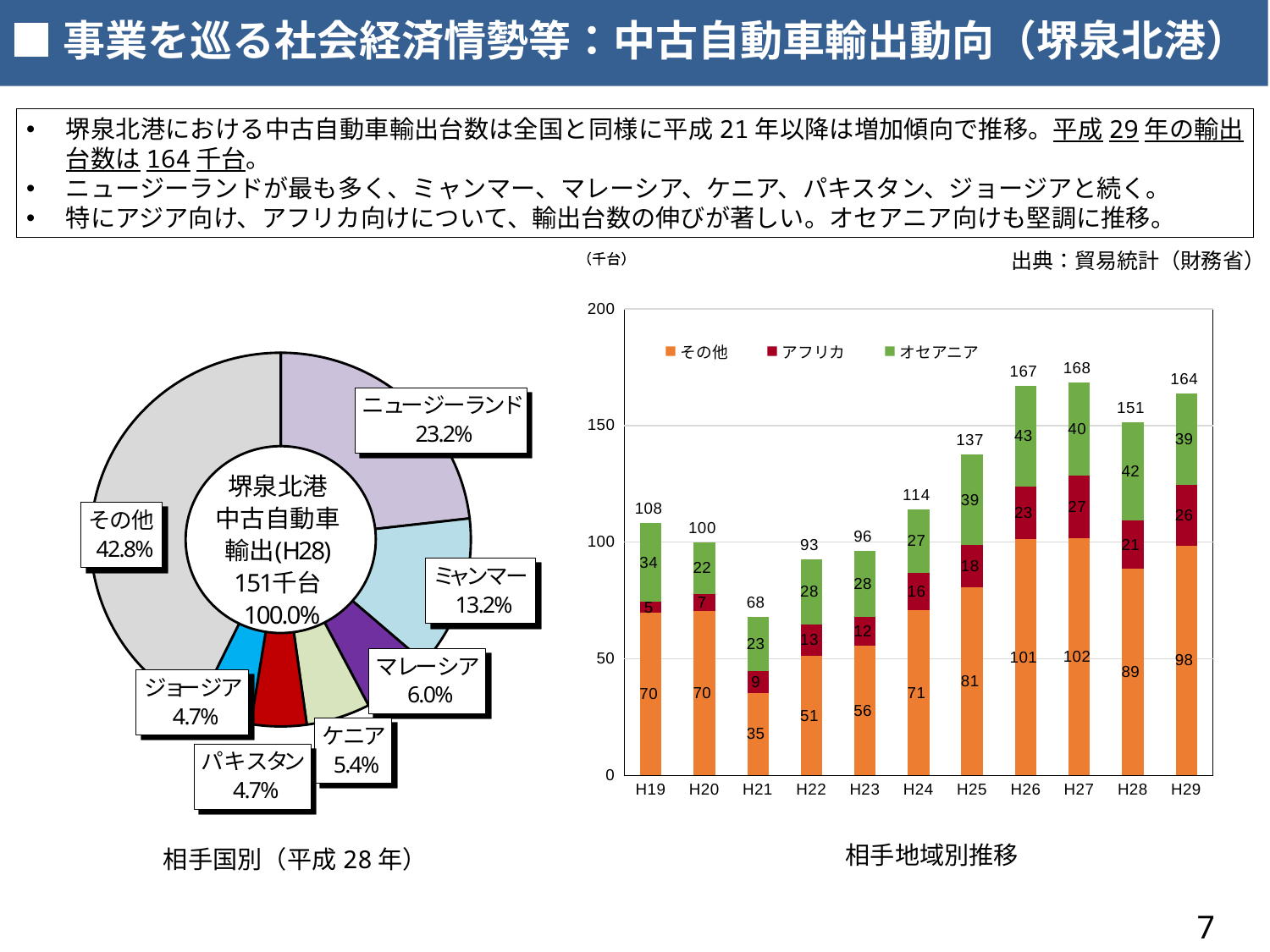
In the bar chart 相手地域別推移, how many years are shown on the x axis? 11 In the bar chart 相手地域別推移, which year has the highest total? H27 In the bar chart 相手地域別推移, what is the value of アフリカ for H27? 27 In the bar chart 相手地域別推移, what is the total value for H29? 164 In the bar chart 相手地域別推移, how many series does the legend list? 3 In the bar chart 相手地域別推移, what is the difference between the total for H29 and the total for H28? 13 In the pie chart 相手国別（平成28年）, what share does ニュージーランド have? 23.2% In the bar chart 相手地域別推移, is the value of その他 for H25 larger than the value of その他 for H24? Yes, 81 vs 71 In the bar chart 相手地域別推移, which year has the lowest total? H21 What type of chart is the chart on the left of the slide? Pie chart In the bar chart 相手地域別推移, what is the value of オセアニア for H26? 43 In the pie chart 相手国別（平成28年）, which named country has the largest share? ニュージーランド